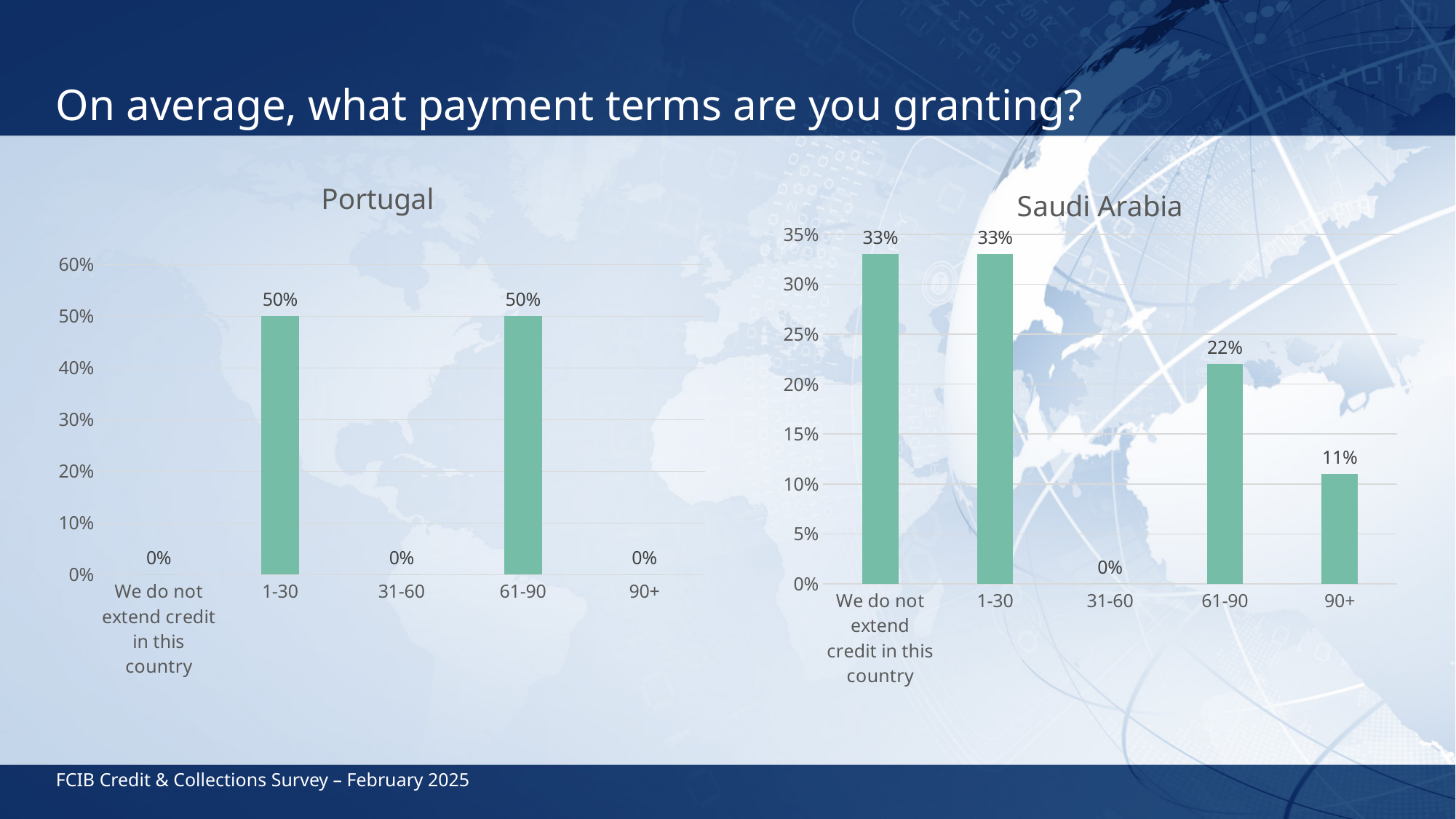
What type of chart is the Saudi Arabia chart? Bar chart In the Saudi Arabia chart, which is larger, the value for 1-30 or the value for 61-90? 1-30 In the Portugal chart, how many categories are shown on the x axis? 5 What is the title of the chart on the left side of the slide? Portugal In the Saudi Arabia chart, which category has the lowest value? 31-60 In the Saudi Arabia chart, what is the value for 90+? 11% In the Saudi Arabia chart, what is the value for 'We do not extend credit in this country'? 33% In the Saudi Arabia chart, what is the difference between the values for 61-90 and 90+? 11% In the Portugal chart, what is the value for 1-30? 50% In the Portugal chart, what is the difference between the values for 1-30 and 61-90? 0% In the Portugal chart, what is the value for 31-60? 0% In the Saudi Arabia chart, what is the value for 61-90? 22%